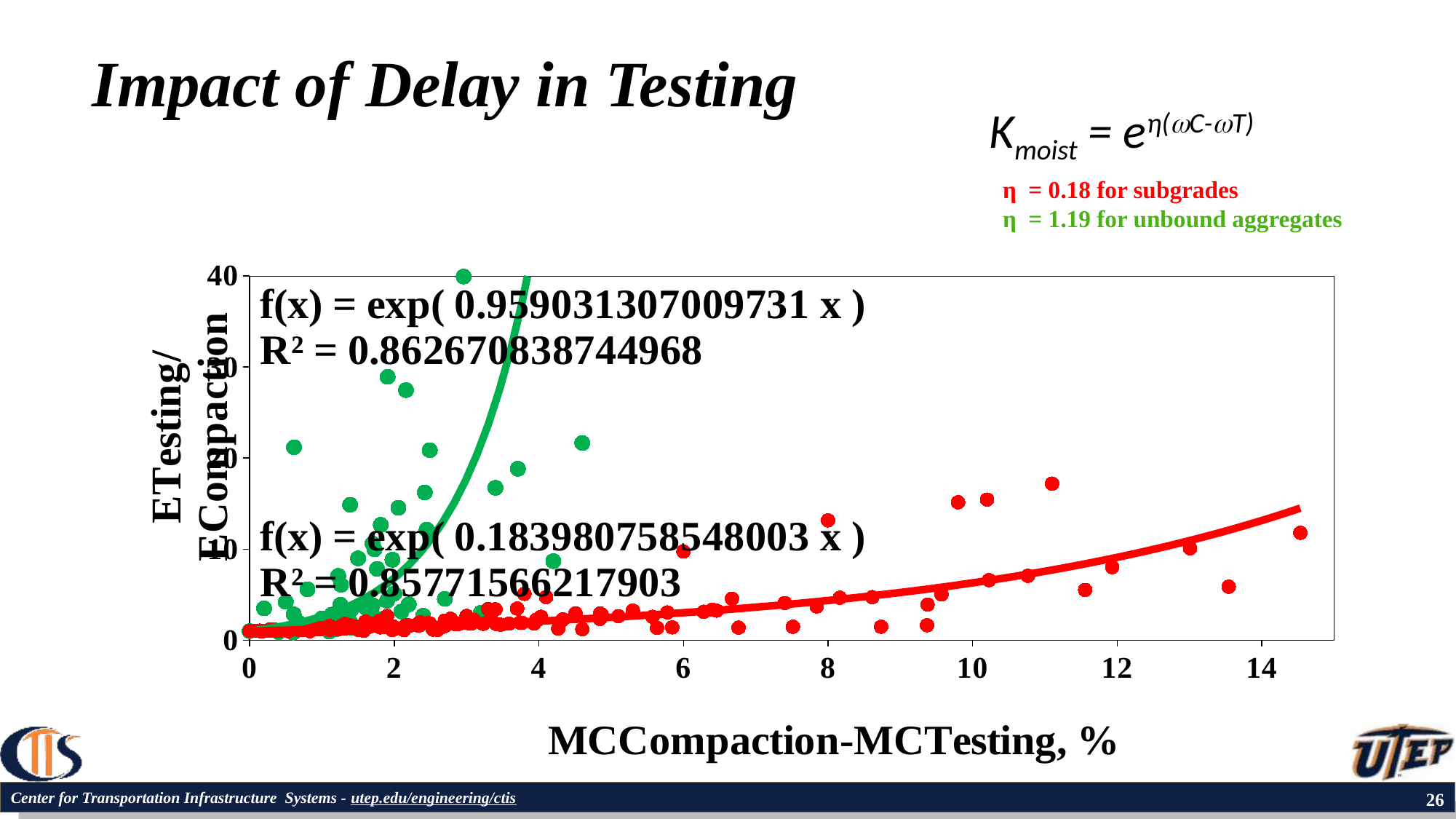
What is the title of the x axis of the chart? MCCompaction-MCTesting, % What kind of chart is shown on the slide? scatter chart Which trendline has the higher R² value, the upper (green) one or the lower (red) one? the upper (green) one What is the coefficient of x in the upper trendline equation f(x) = exp( ... x )? 0.959031307009731 How many trendlines are drawn on the chart? 2 What is the difference between the two R² values printed on the chart? 0.004955176565938 Is the y value of the highest green point greater or less than 30? greater What is the coefficient of x in the lower trendline equation f(x) = exp( ... x )? 0.183980758548003 What is the R² value printed for the green trendline (the upper equation)? 0.862670838744968 Do the red data points generally rise or fall as the x value increases? rise What is the R² value printed for the red trendline (the lower equation)? 0.85771566217903 What is the largest tick value shown on the x axis? 14